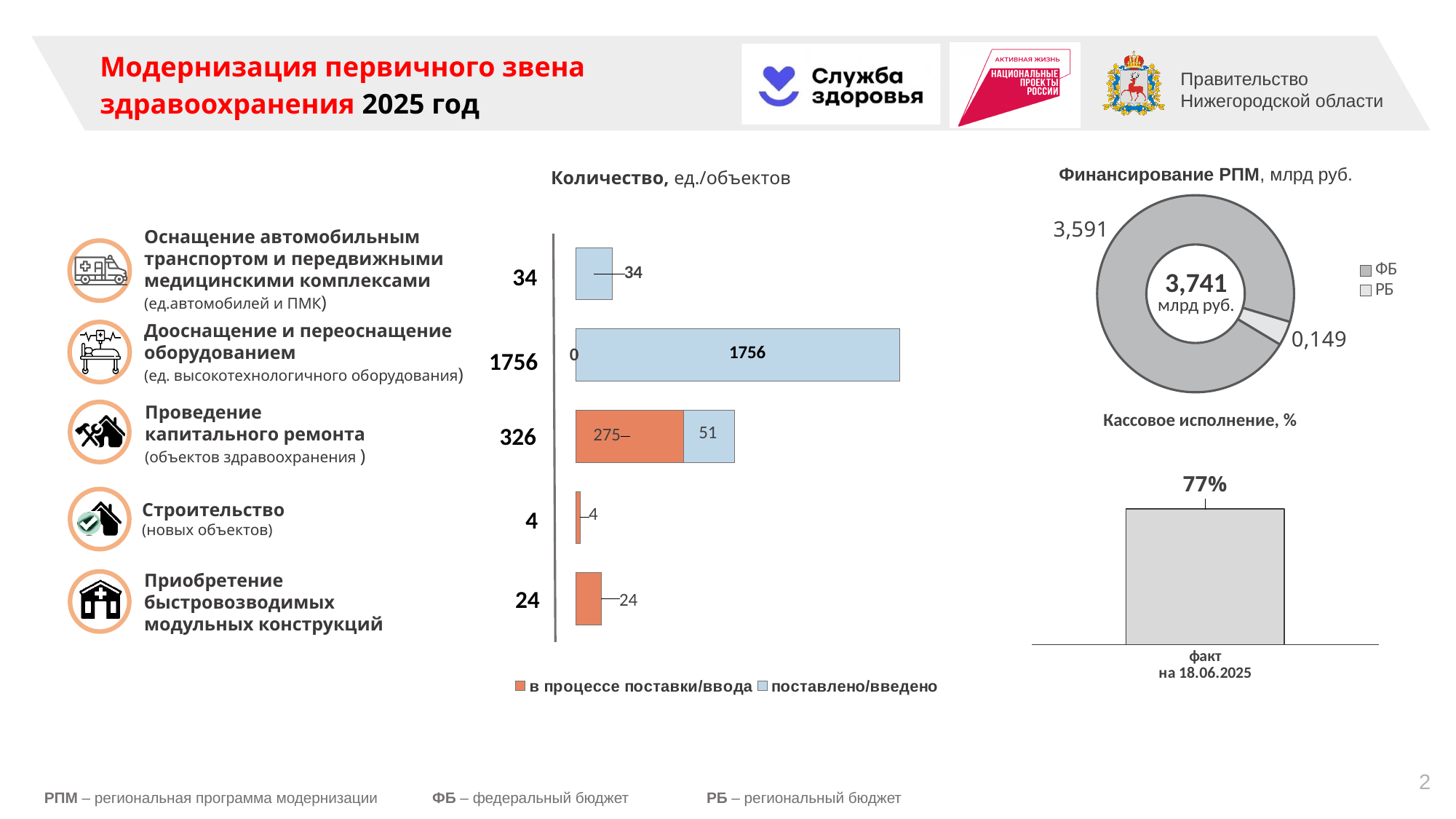
In the 'Количество, ед./объектов' chart, what is the difference between the totals for 'Оснащение автомобильным транспортом и передвижными медицинскими комплексами' and 'Приобретение быстровозводимых модульных конструкций'? 10 In the 'Количество, ед./объектов' chart, what is the 'поставлено/введено' value for 'Проведение капитального ремонта'? 51 How many series does the legend of the 'Количество, ед./объектов' chart list? 2 In the 'Количество, ед./объектов' chart, which category has the highest total? Дооснащение и переоснащение оборудованием In the 'Финансирование РПМ, млрд руб.' chart, what is the value for ФБ? 3,591 How many categories are shown in the 'Количество, ед./объектов' chart? 5 In the 'Количество, ед./объектов' chart, which category has the lowest total? Строительство In the 'Количество, ед./объектов' chart, what is the 'в процессе поставки/ввода' value for 'Проведение капитального ремонта'? 275 In the 'Количество, ед./объектов' chart, what is the 'поставлено/введено' value for 'Дооснащение и переоснащение оборудованием'? 1756 In the 'Финансирование РПМ, млрд руб.' chart, what is the value for РБ? 0,149 In the 'Кассовое исполнение, %' chart, what is the value for 'факт на 18.06.2025'? 77% In the 'Количество, ед./объектов' chart, what is the total for 'Проведение капитального ремонта'? 326